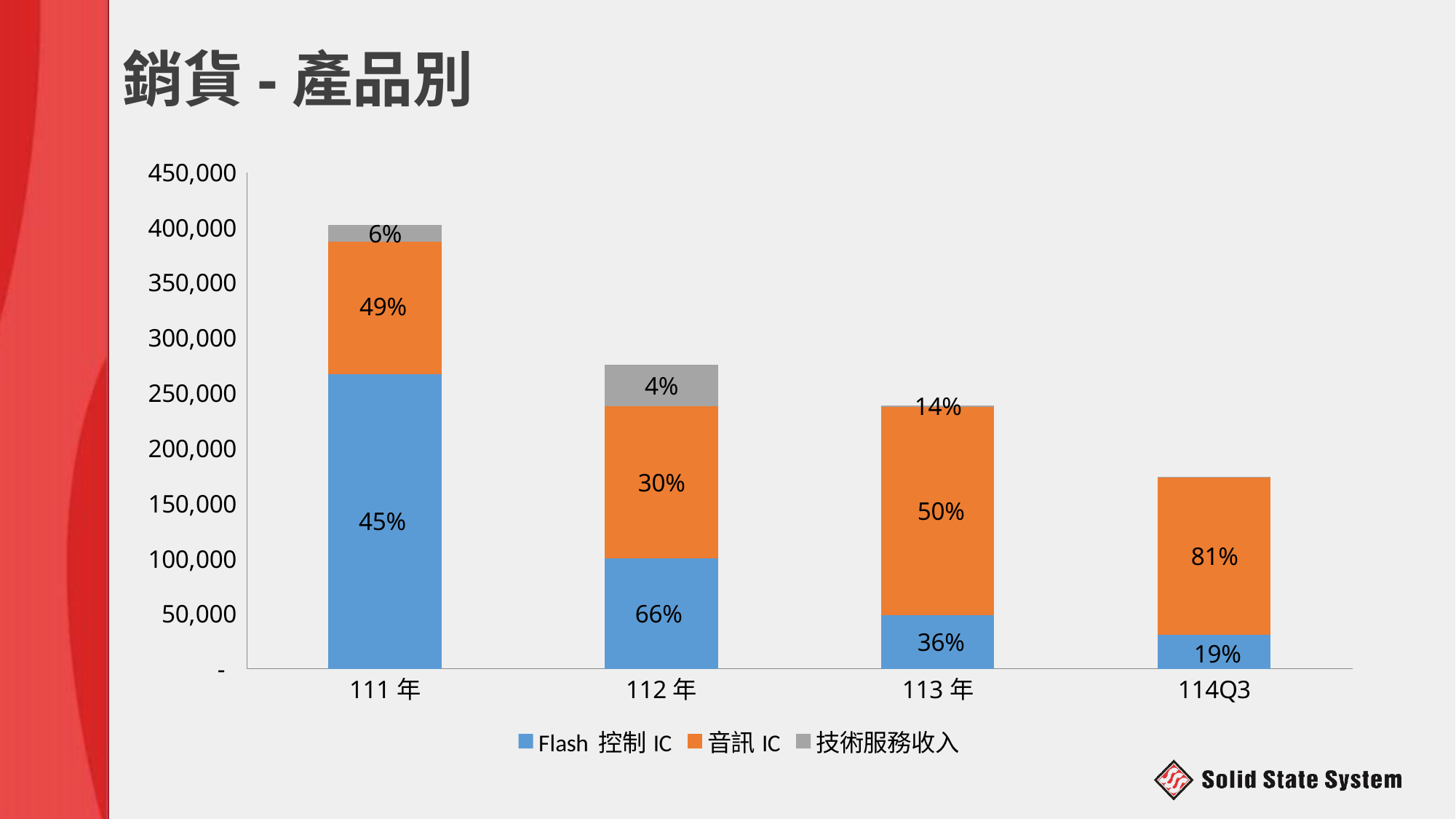
Which category has the tallest stacked bar? 111 年 How many series does the legend list? 3 Do the total stacked bar heights rise or fall from 111 年 to 114Q3? fall How many categories are shown on the x axis? 4 What is the title of the chart? 銷貨 - 產品別 What kind of chart is shown on the slide? Stacked bar chart What percentage label is shown for 音訊 IC in 114Q3? 81% Is the total stacked bar for 114Q3 greater or less than 200,000? less What percentage label is shown for Flash 控制 IC in 111 年? 45% In 112 年, which has the larger percentage label, Flash 控制 IC or 音訊 IC? Flash 控制 IC Which category has the shortest stacked bar? 114Q3 What percentage label is shown for 技術服務收入 in 112 年? 4%